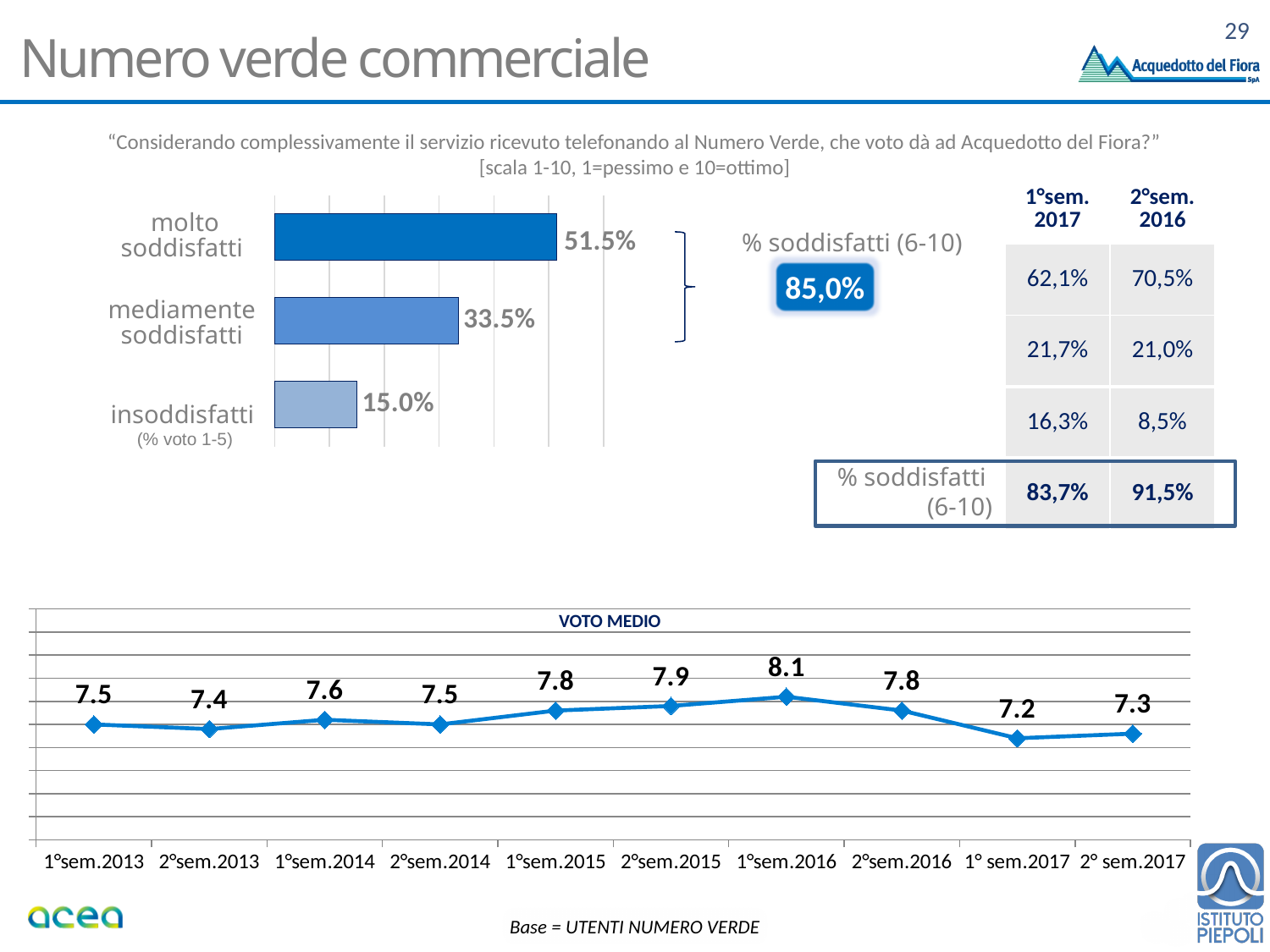
In the bar chart at the top of the slide, what is the value for "molto soddisfatti"? 51.5% In the bar chart at the top of the slide, how many categories are shown? 3 In the bar chart at the top of the slide, which category has the highest value? molto soddisfatti In the "VOTO MEDIO" chart, which period has the highest value? 1°sem.2016 In the bar chart at the top of the slide, what is the difference between "molto soddisfatti" and "mediamente soddisfatti"? 18.0% In the "VOTO MEDIO" chart, how many data points are plotted? 10 In the "VOTO MEDIO" chart, is the value for 2°sem.2015 larger or smaller than the value for 2° sem.2017? larger In the "VOTO MEDIO" chart, what is the value for 1°sem.2016? 8.1 What kind of chart is the chart at the top left of the slide? bar chart In the bar chart at the top of the slide, which category has the lowest value? insoddisfatti In the "VOTO MEDIO" chart, what is the value for 1° sem.2017? 7.2 In the bar chart at the top of the slide, what is the value for "insoddisfatti"? 15.0%